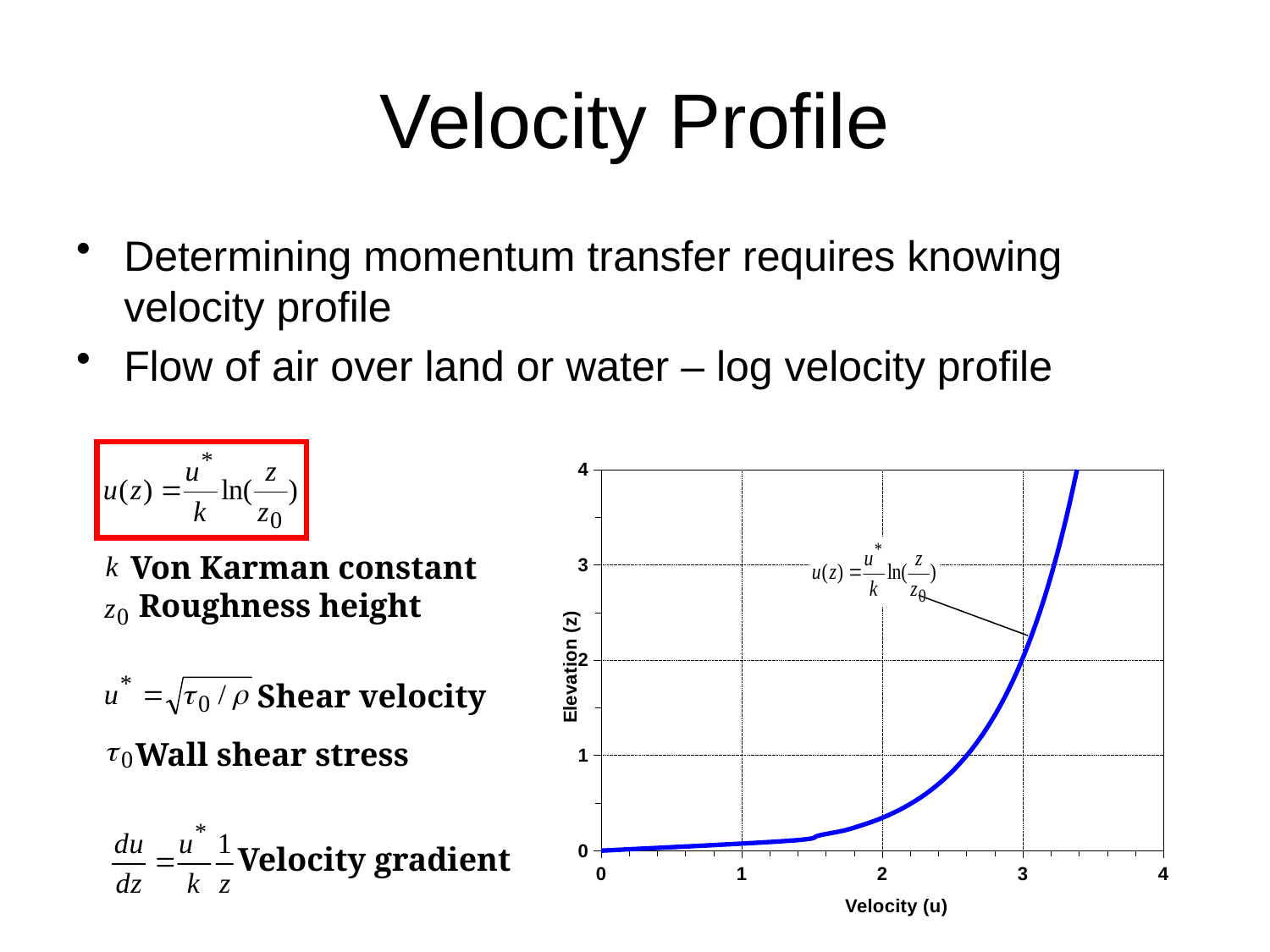
Is the elevation at a velocity of 1 greater or less than 1? less What is the label of the y axis of the chart? Elevation (z) Which is larger: the elevation at a velocity of 3 or the elevation at a velocity of 2? the elevation at a velocity of 3 What is the highest value labelled on the x axis of the chart? 4 Is the velocity at an elevation of 3 greater or less than 3? greater Is the velocity at an elevation of 1 greater or less than 2? greater As velocity increases along the x axis, does the elevation curve rise or fall? rise What is the label of the x axis of the chart? Velocity (u) How many curves are plotted on the chart? 1 What kind of chart is shown on the slide? line chart